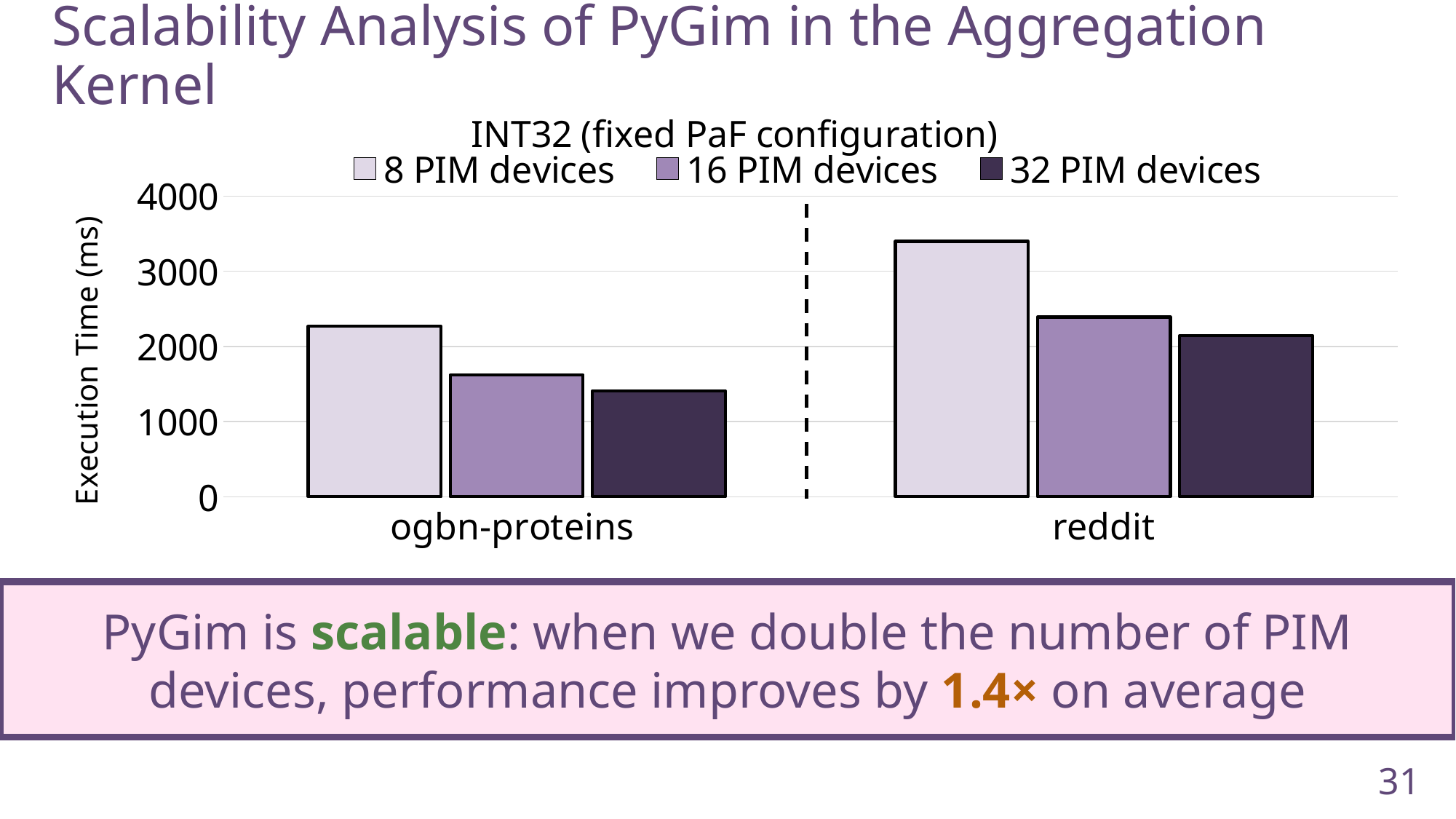
How many dataset categories are shown on the x axis? 2 Is the execution time for 8 PIM devices on ogbn-proteins greater or less than 2000 ms? greater Is the execution time for 8 PIM devices on reddit greater or less than 3000 ms? greater Within each dataset, how does execution time change as the number of PIM devices increases from 8 to 32? It decreases What kind of chart is shown on the slide? bar chart Is the execution time for 32 PIM devices on reddit greater or less than 3000 ms? less Which bar has the highest execution time in the chart? 8 PIM devices on reddit Which bar has the lowest execution time in the chart? 32 PIM devices on ogbn-proteins What is the label of the y axis? Execution Time (ms) How many series does the legend list? 3 For 8 PIM devices, which dataset has the larger execution time, ogbn-proteins or reddit? reddit